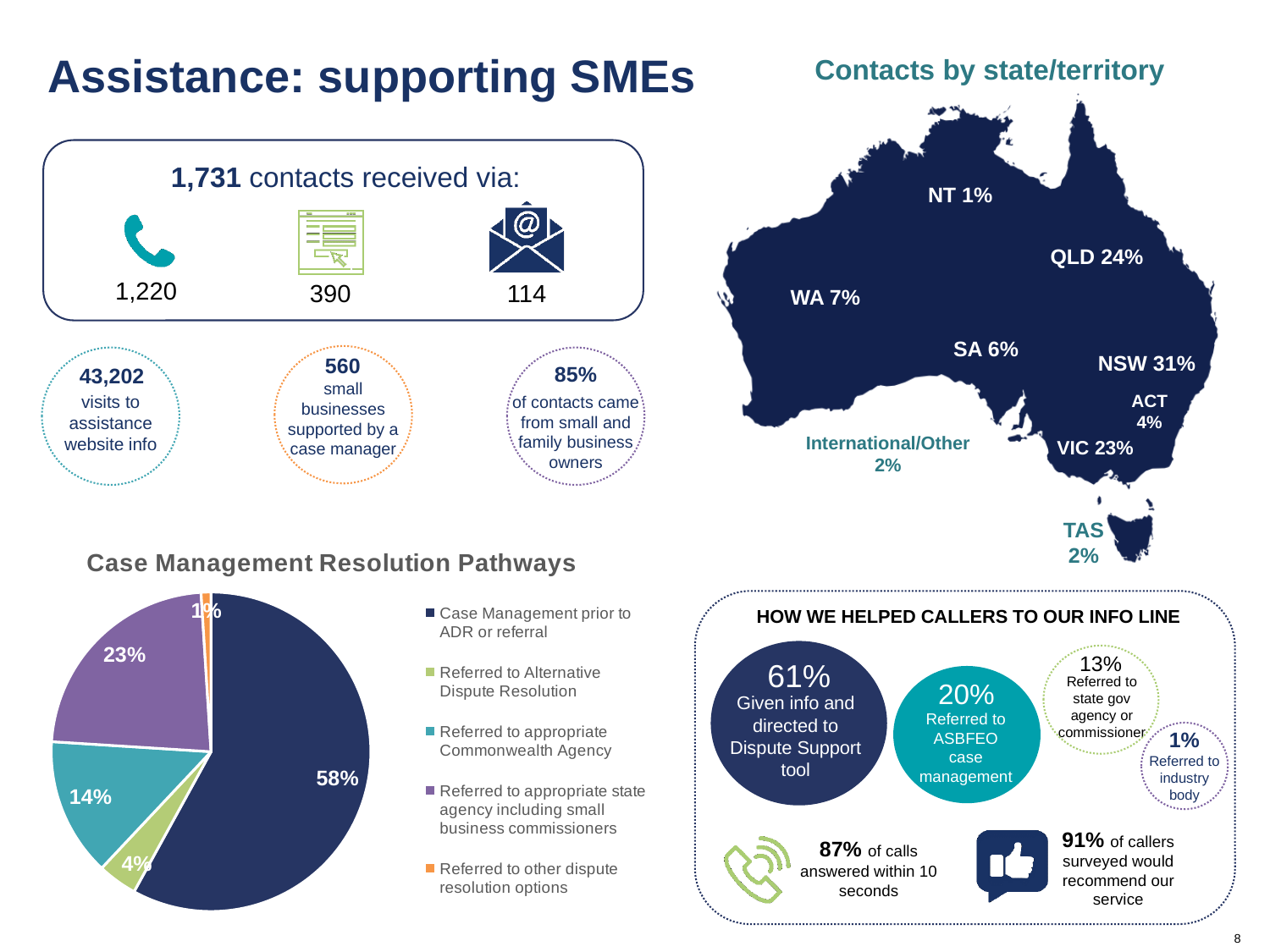
In the Case Management Resolution Pathways pie chart, which category has the smallest slice? Referred to other dispute resolution options In the Case Management Resolution Pathways pie chart, which category has the largest slice? Case Management prior to ADR or referral In the Contacts by state/territory map, which state/territory has the highest share of contacts? NSW In the Case Management Resolution Pathways pie chart, what share is Referred to appropriate Commonwealth Agency? 14% In the Case Management Resolution Pathways pie chart, what is the difference between the Case Management prior to ADR or referral slice and the Referred to appropriate state agency slice? 35% In the Case Management Resolution Pathways pie chart, which is larger: Referred to appropriate Commonwealth Agency or Referred to Alternative Dispute Resolution? Referred to appropriate Commonwealth Agency What kind of chart is the Case Management Resolution Pathways chart? pie chart In the Case Management Resolution Pathways pie chart, what share is Case Management prior to ADR or referral? 58% In the Case Management Resolution Pathways pie chart, what share is Referred to Alternative Dispute Resolution? 4% In the Case Management Resolution Pathways pie chart, how many categories does the legend list? 5 In the Contacts by state/territory map, what percentage of contacts came from NSW? 31%